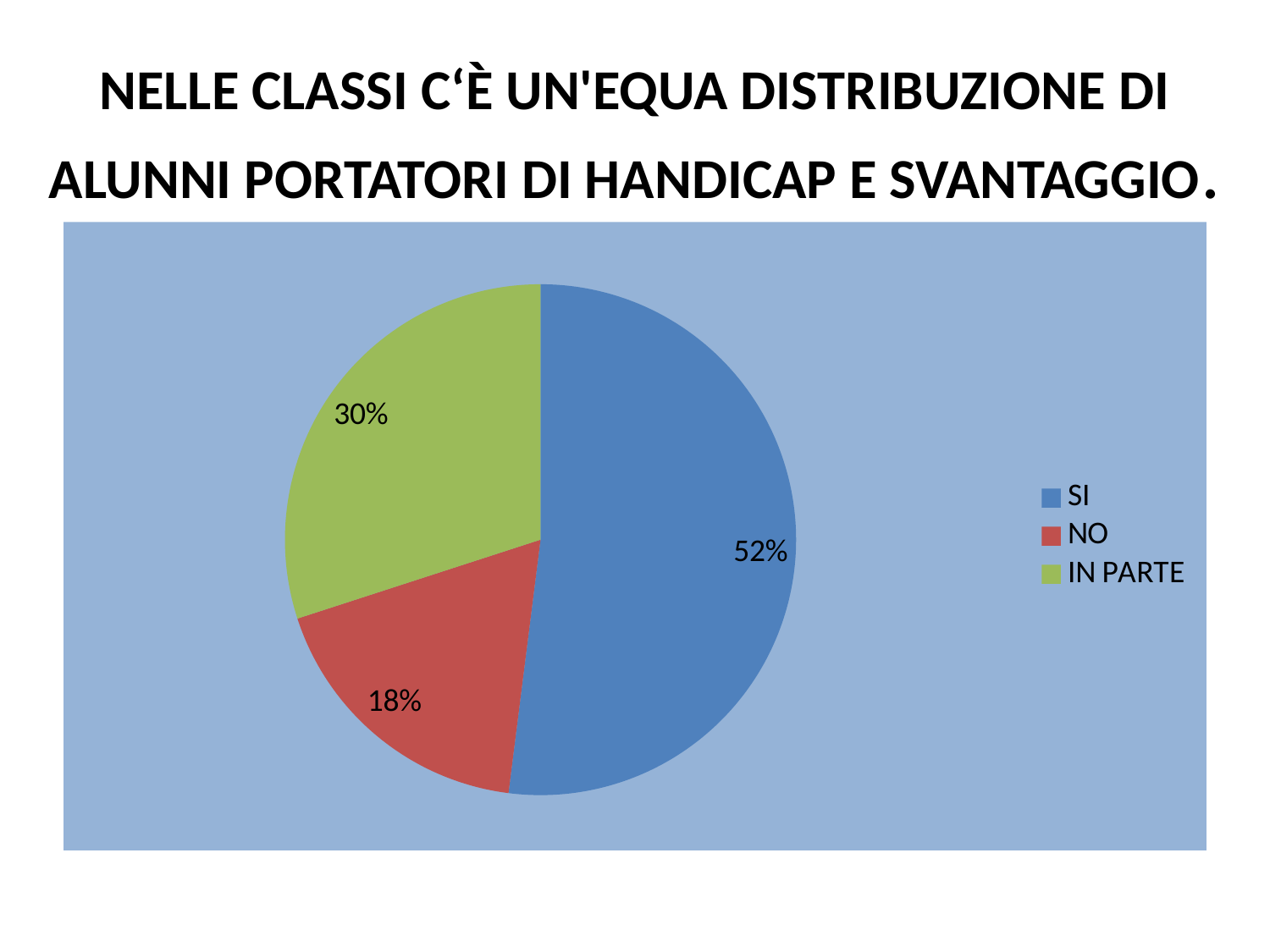
What percentage of the pie does the NO slice represent? 18% What percentage of the pie does the IN PARTE slice represent? 30% What is the difference in percentage points between the IN PARTE slice and the NO slice? 12 What kind of chart is shown on the slide? Pie chart Which category has the largest share of the pie? SI What colour is the SI slice in the pie chart? Blue What percentage of the pie does the SI slice represent? 52% What are the three legend entries of the chart? SI, NO, IN PARTE What is the difference in percentage points between the SI slice and the IN PARTE slice? 22 Which is larger, the NO slice or the IN PARTE slice? IN PARTE Which category has the smallest share of the pie? NO How many slices does the pie chart have? 3